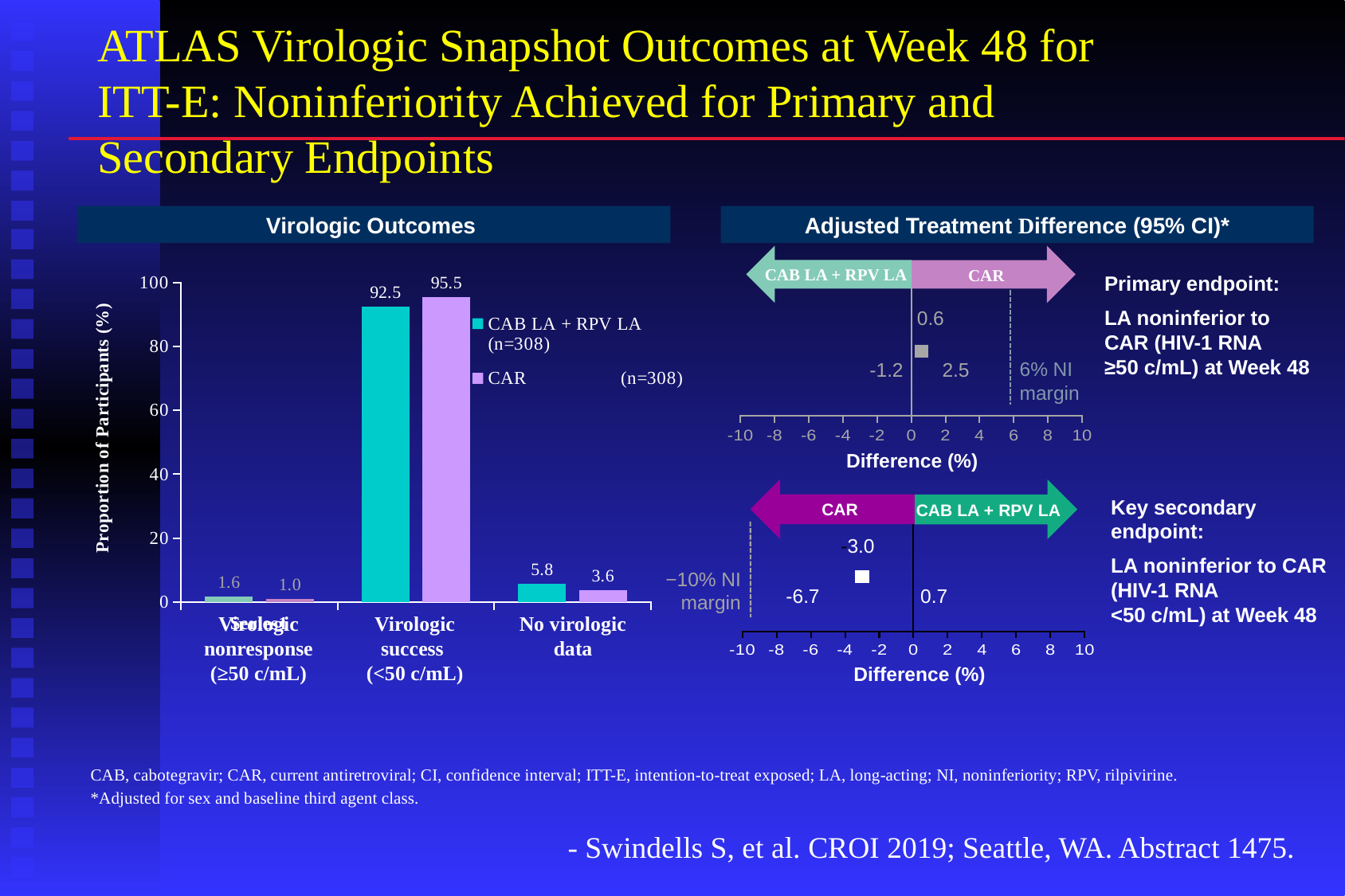
In the Virologic Outcomes chart, what is the value for CAB LA + RPV LA in the Virologic success (<50 c/mL) category? 92.5 In the Virologic Outcomes chart, which series has the larger value in the No virologic data category? CAB LA + RPV LA In the Adjusted Treatment Difference chart for the primary endpoint, what is the point estimate of the difference? 0.6 How many series does the legend of the Virologic Outcomes chart list? 2 In the Virologic Outcomes chart, what is the value for CAR in the Virologic nonresponse (≥50 c/mL) category? 1.0 In the Virologic Outcomes chart, what is the value for CAR in the Virologic success (<50 c/mL) category? 95.5 In the Virologic Outcomes chart, what is the difference between the CAR and CAB LA + RPV LA values for Virologic success (<50 c/mL)? 3.0 In the Adjusted Treatment Difference chart for the key secondary endpoint, what are the lower and upper limits of the 95% CI? -6.7 and 0.7 What kind of chart is the Virologic Outcomes chart? Bar chart What is the y-axis title of the Virologic Outcomes chart? Proportion of Participants (%) In the Virologic Outcomes chart, what is the value for CAB LA + RPV LA in the No virologic data category? 5.8 In the Virologic Outcomes chart, which category has the highest values for both series? Virologic success (<50 c/mL)